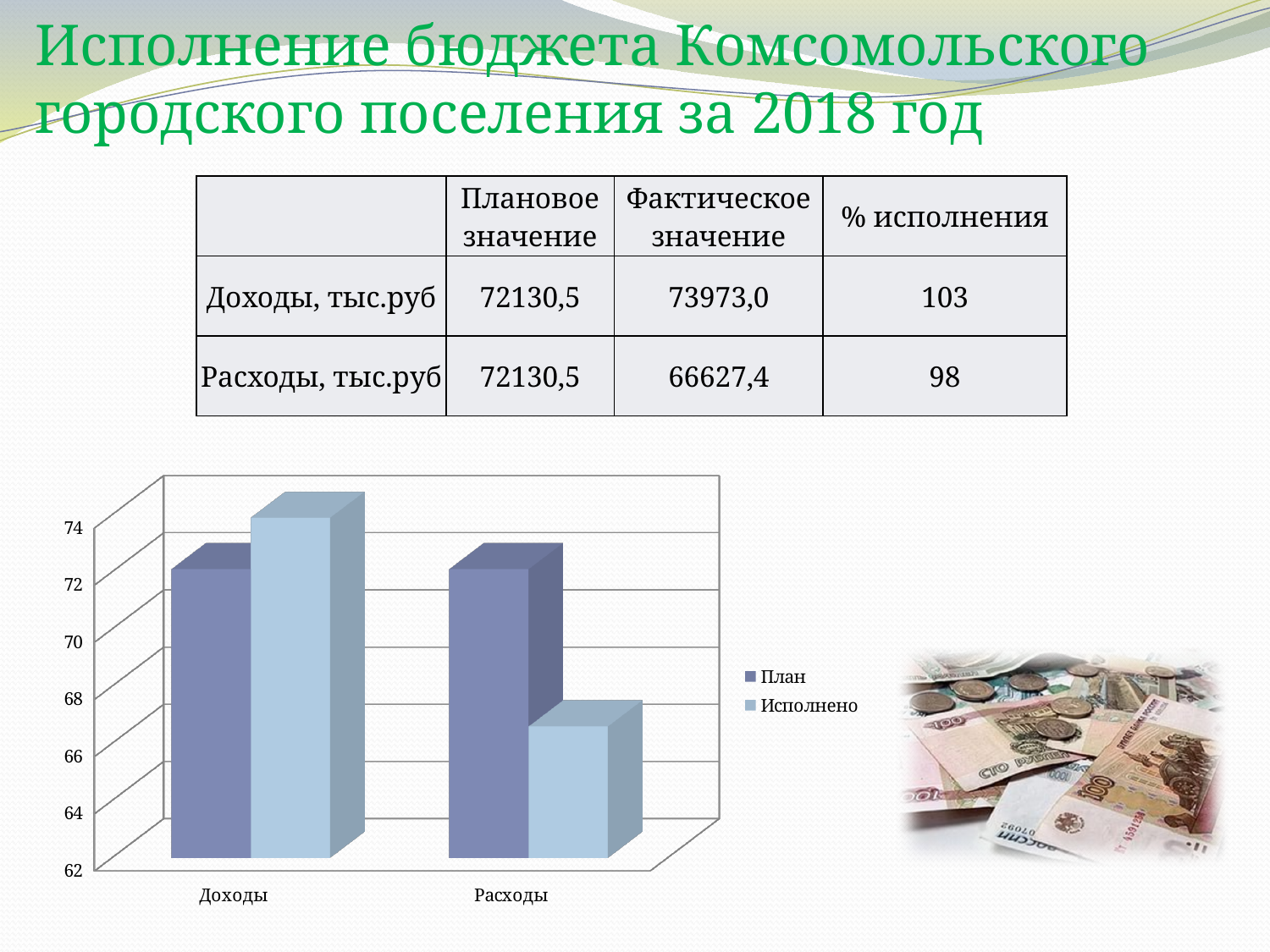
Is the План value for Доходы greater or less than 70? greater Is the Исполнено value for Доходы greater or less than 72? greater How many series does the chart legend list? 2 For Расходы, which is larger: План or Исполнено? План Which colour represents the Исполнено series in the chart? light blue What are the two series named in the chart legend? План, Исполнено Which bar in the chart is the shortest? Исполнено for Расходы Is the Исполнено value for Расходы greater or less than 68? less For Доходы, which is larger: План or Исполнено? Исполнено What kind of chart is shown on the slide? bar chart Which bar in the chart is the tallest? Исполнено for Доходы How many categories are shown on the x axis of the chart? 2